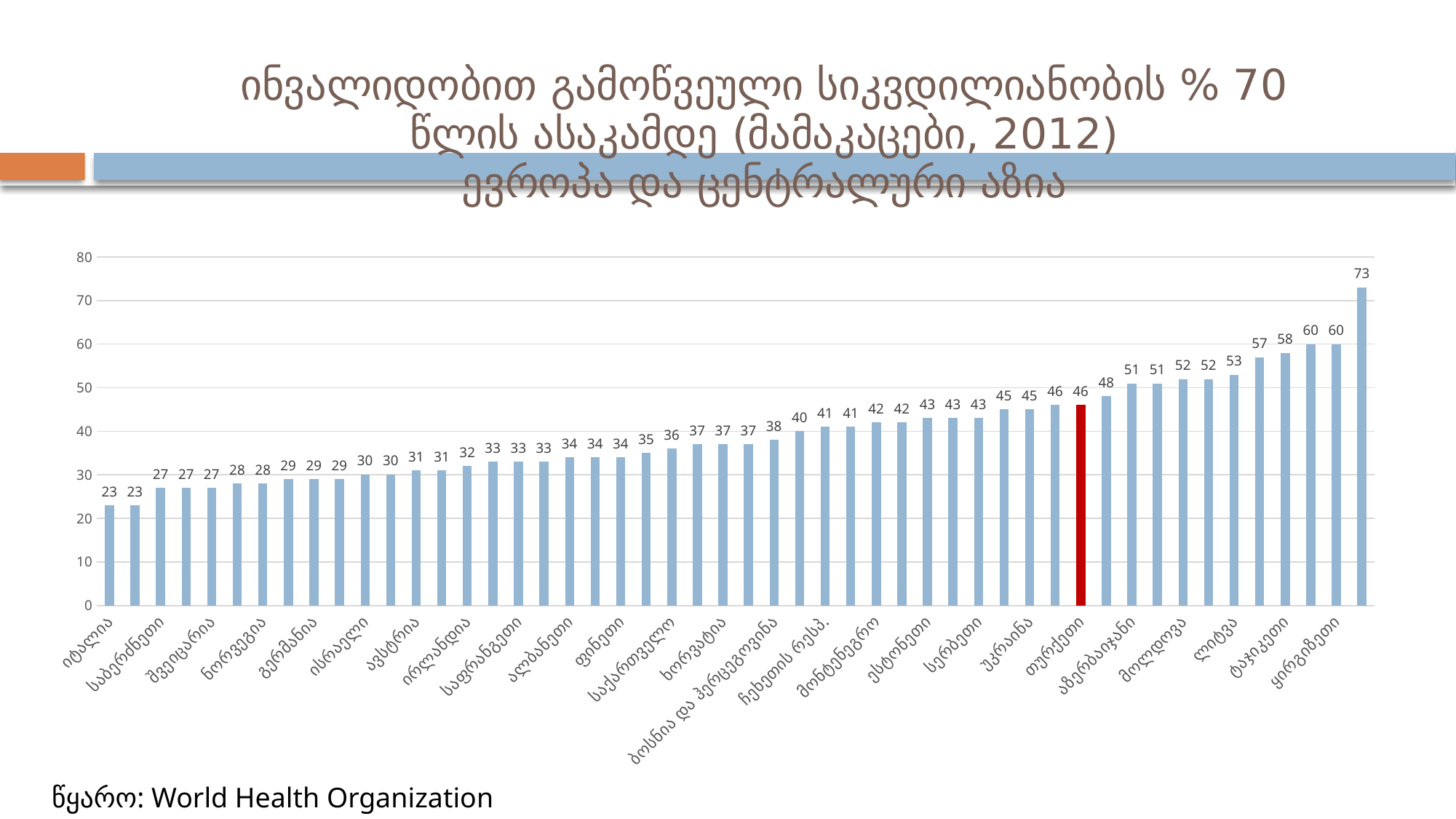
What is the value for აზერბაიჯანი? 51 Which is larger, the value for იტალია or the value for აზერბაიჯანი? აზერბაიჯანი What source is cited at the bottom of the slide? World Health Organization What is the difference between the value for აზერბაიჯანი and the value for იტალია? 28 What is the value for მოლდოვა? 52 What kind of chart is shown on the slide? bar chart What is the lowest value shown in the chart? 23 What is the value for იტალია? 23 Do the values rise or fall from left to right along the x axis? rise What is the value of the red-highlighted bar? 46 What is the highest value shown in the chart? 73 What is the value for ნორვეგია? 28